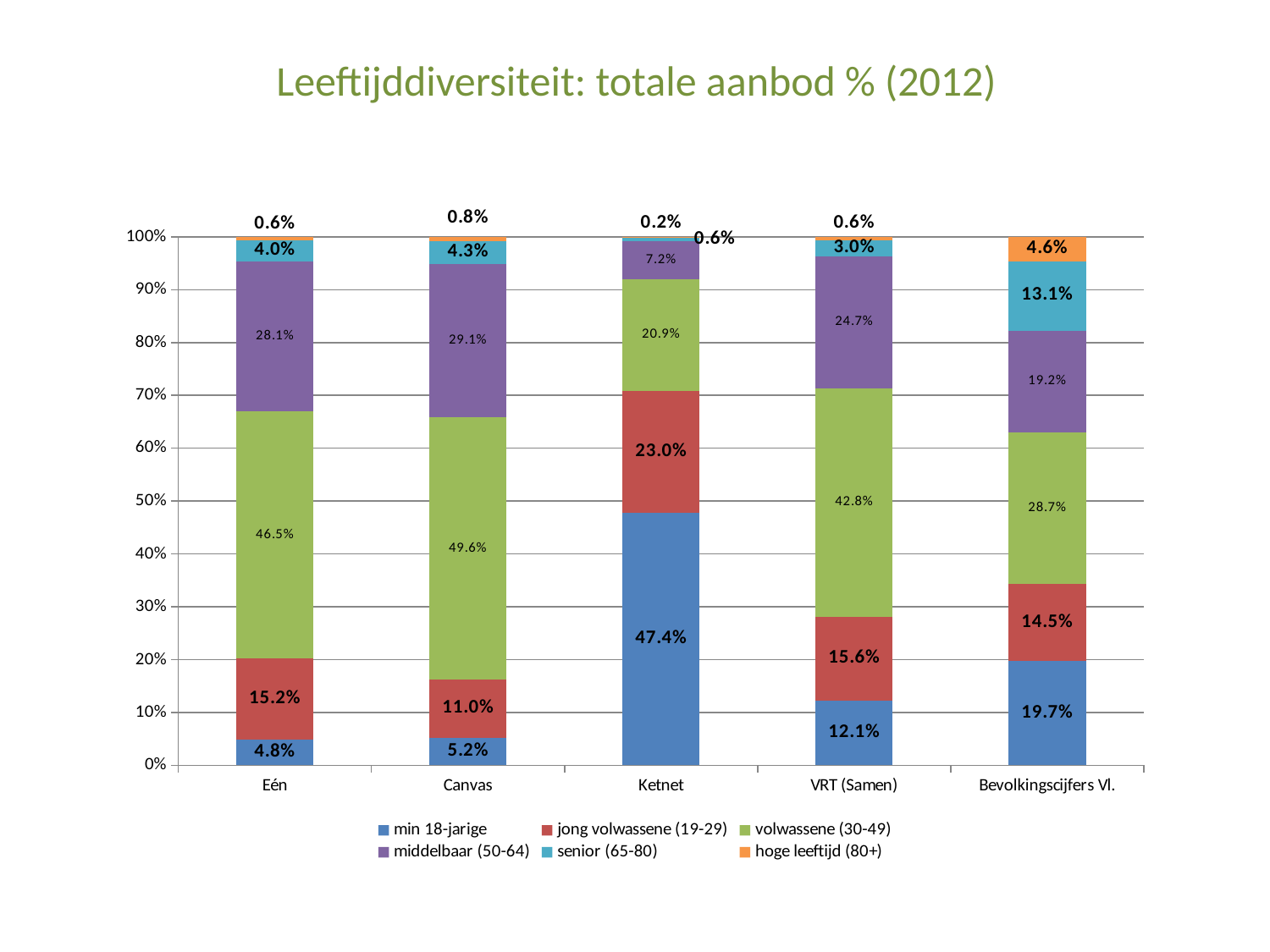
Which category has the lowest value for 'min 18-jarige'? Eén Which has the larger 'middelbaar (50-64)' value, Eén or Canvas? Canvas How many categories are shown on the x axis? 5 What is the value for 'min 18-jarige' in the Ketnet bar? 47.4% What is the value for 'senior (65-80)' in the VRT (Samen) bar? 3.0% What is the value for 'hoge leeftijd (80+)' in the Bevolkingscijfers Vl. bar? 4.6% How many series does the legend list? 6 What is the difference between the 'jong volwassene (19-29)' values for Eén and Canvas? 4.2 percentage points What is the value for 'volwassene (30-49)' in the Canvas bar? 49.6% What is the difference between the 'volwassene (30-49)' values for VRT (Samen) and Bevolkingscijfers Vl.? 14.1 percentage points What kind of chart is shown on the slide? Stacked bar chart Which category has the highest value for 'min 18-jarige'? Ketnet